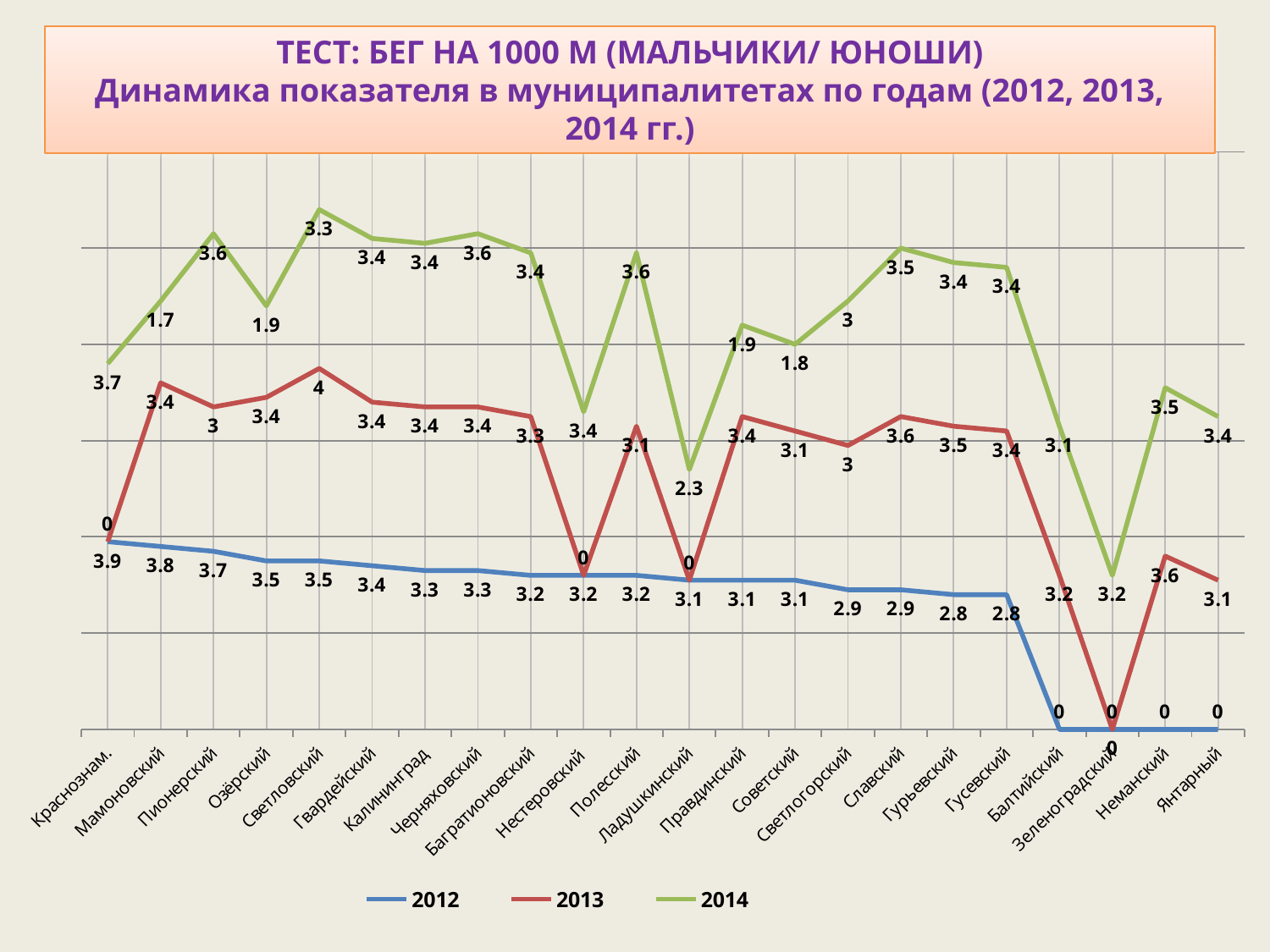
What is the difference between the 2013 values for Светловский and Пионерский? 1 How many municipalities are shown on the x axis? 22 Which municipality has the highest labelled 2013 value? Светловский What is the 2013 value for Зеленоградский? 0 Which municipality has the lowest labelled 2014 value? Мамоновский Do the 2012 values rise or fall from Краснознам. to Гусевский? fall How many series does the legend list? 3 What kind of chart is shown on the slide? line chart What is the 2012 value for Краснознам.? 3.9 What is the 2013 value for Светловский? 4 What is the 2014 value for Ладушкинский? 2.3 Which is larger for Неманский: the 2013 value or the 2014 value? 2013